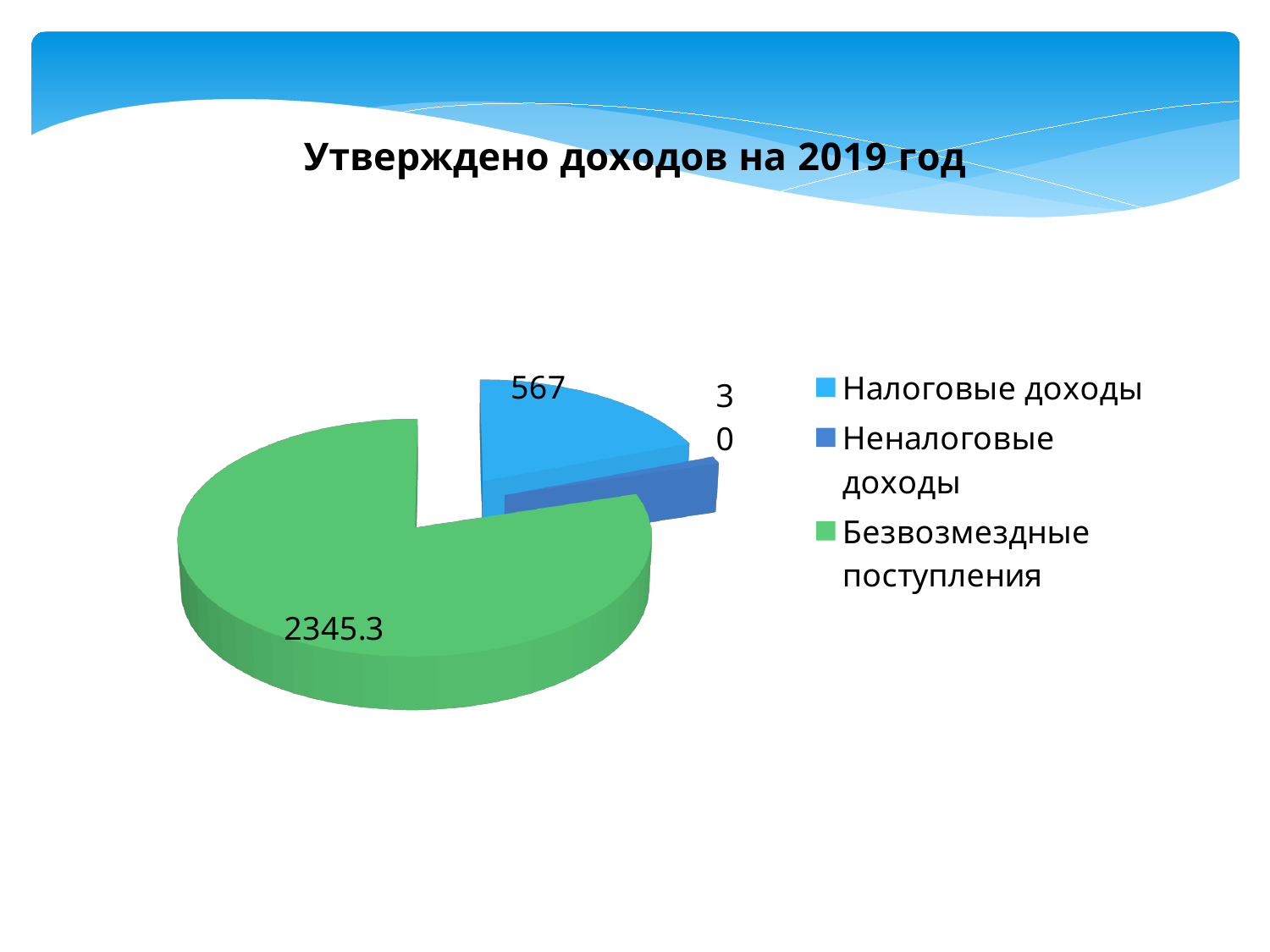
What is the title of the chart? Утверждено доходов на 2019 год What is the value for Налоговые доходы? 567 How many entries does the legend list? 3 Which category has the largest slice of the pie? Безвозмездные поступления What kind of chart is shown on the slide? Pie chart What colour is the slice for Безвозмездные поступления? Green How many categories does the pie chart have? 3 Which is larger, the value for Налоговые доходы or the value for Неналоговые доходы? Налоговые доходы Which category has the smallest slice of the pie? Неналоговые доходы What is the value for Безвозмездные поступления? 2345.3 What is the difference between the values for Безвозмездные поступления and Налоговые доходы? 1778.3